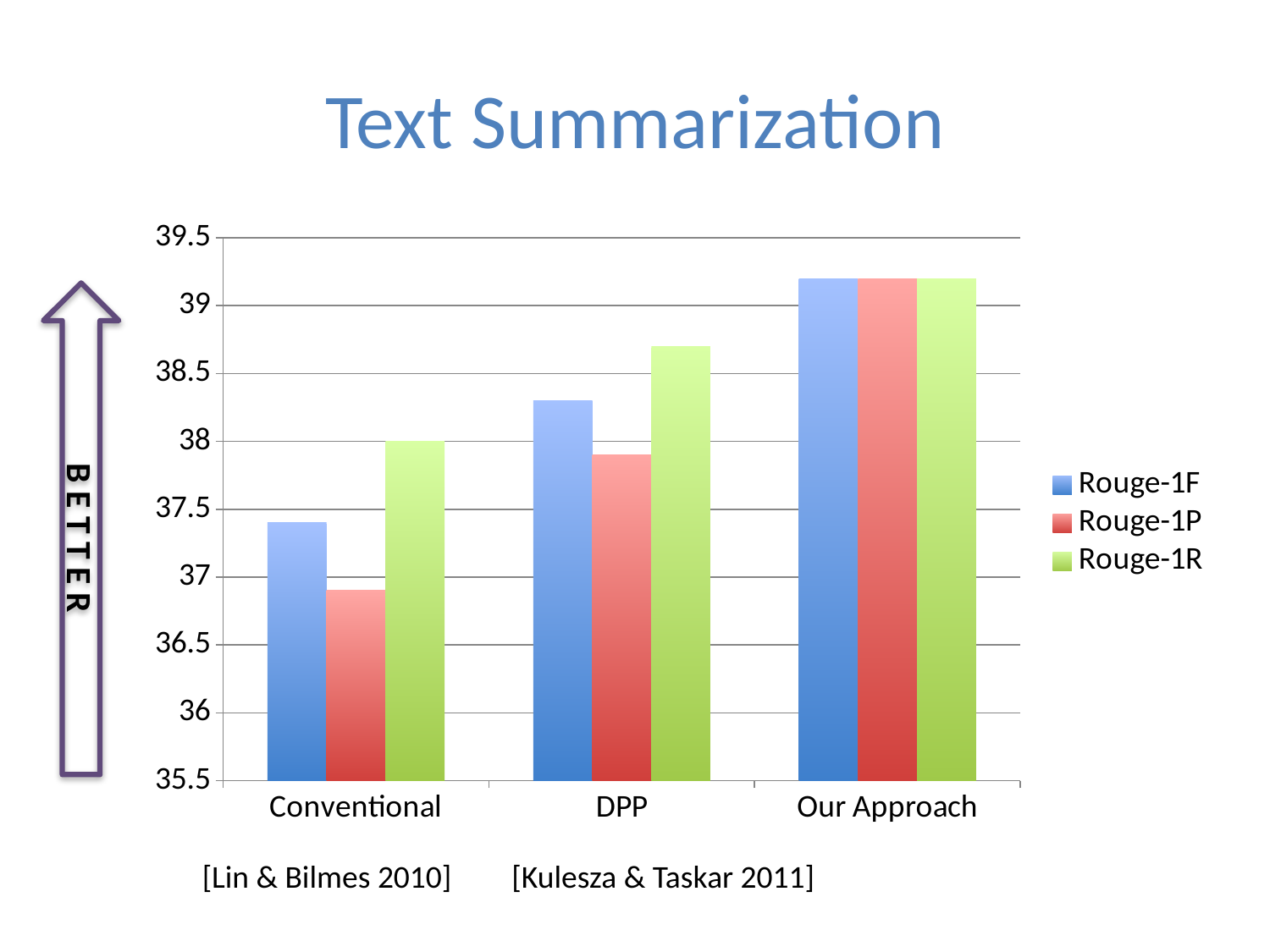
Which category has the lowest Rouge-1P value? Conventional What kind of chart is shown on the slide? bar chart Is the Rouge-1R value for DPP greater or less than 38.5? greater Is the Rouge-1P value for Conventional greater or less than 37? less Which category has the highest Rouge-1F value? Our Approach How many series does the legend list? 3 Which category has the lowest Rouge-1R value? Conventional Is the Rouge-1F value for Conventional greater or less than 37.5? less How many categories are shown on the x axis? 3 Which is larger, the Rouge-1F value for DPP or the Rouge-1P value for DPP? Rouge-1F Do the Rouge-1P values rise or fall from Conventional to Our Approach? rise